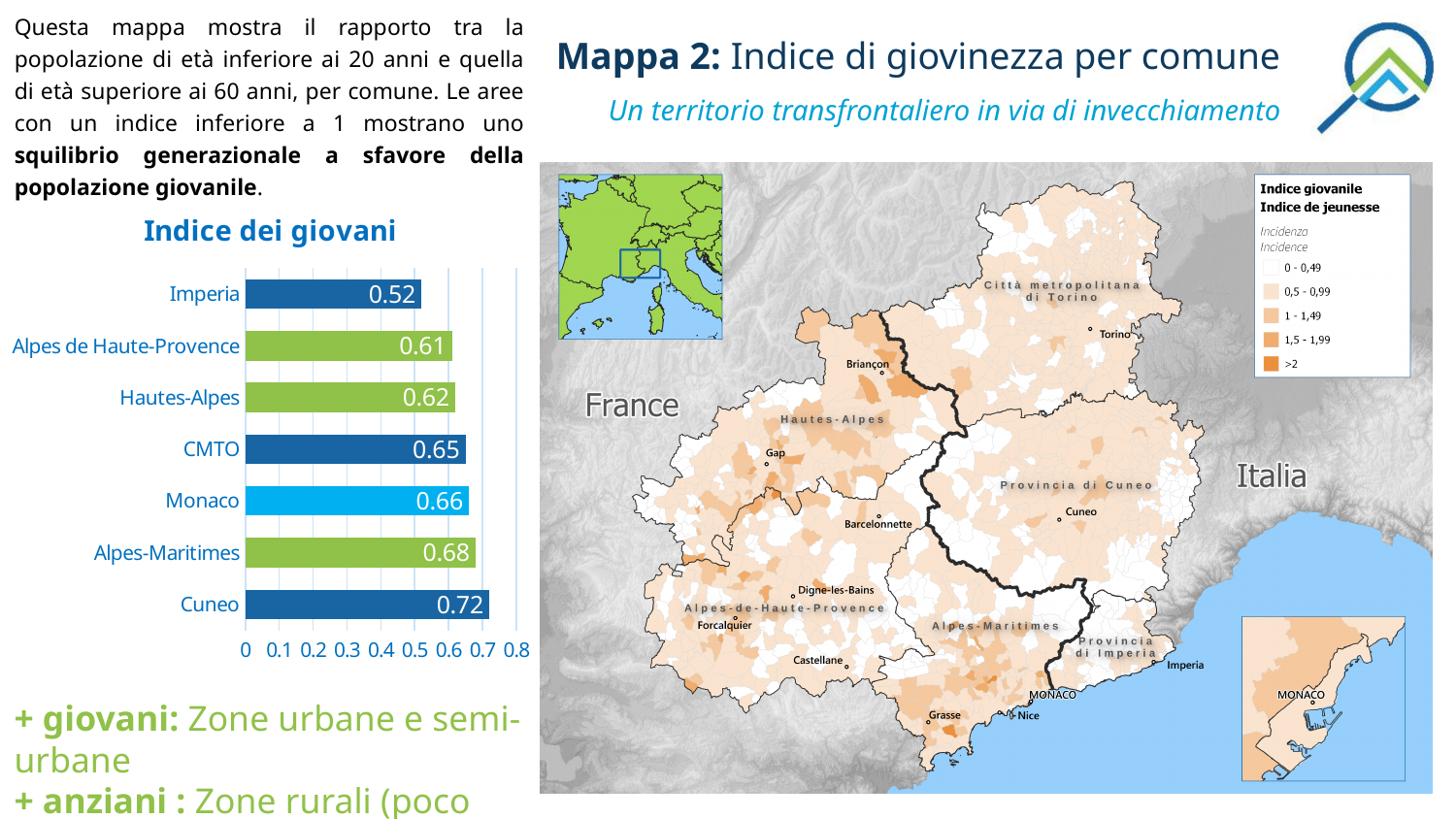
In the 'Indice dei giovani' chart, which is larger: the value for Alpes-Maritimes or the value for CMTO? Alpes-Maritimes What kind of chart is the 'Indice dei giovani' chart? Bar chart Which category has the lowest value in the 'Indice dei giovani' chart? Imperia What is the value for Monaco in the 'Indice dei giovani' chart? 0.66 Which category has the highest value in the 'Indice dei giovani' chart? Cuneo What is the title of the bar chart on the left of the slide? Indice dei giovani What is the value for Hautes-Alpes in the 'Indice dei giovani' chart? 0.62 How many categories are shown in the 'Indice dei giovani' chart? 7 What is the difference between the values for Alpes de Haute-Provence and Hautes-Alpes in the 'Indice dei giovani' chart? 0.01 What is the value for Imperia in the 'Indice dei giovani' chart? 0.52 What is the difference between the values for Cuneo and Imperia in the 'Indice dei giovani' chart? 0.20 What is the value for Cuneo in the 'Indice dei giovani' chart? 0.72